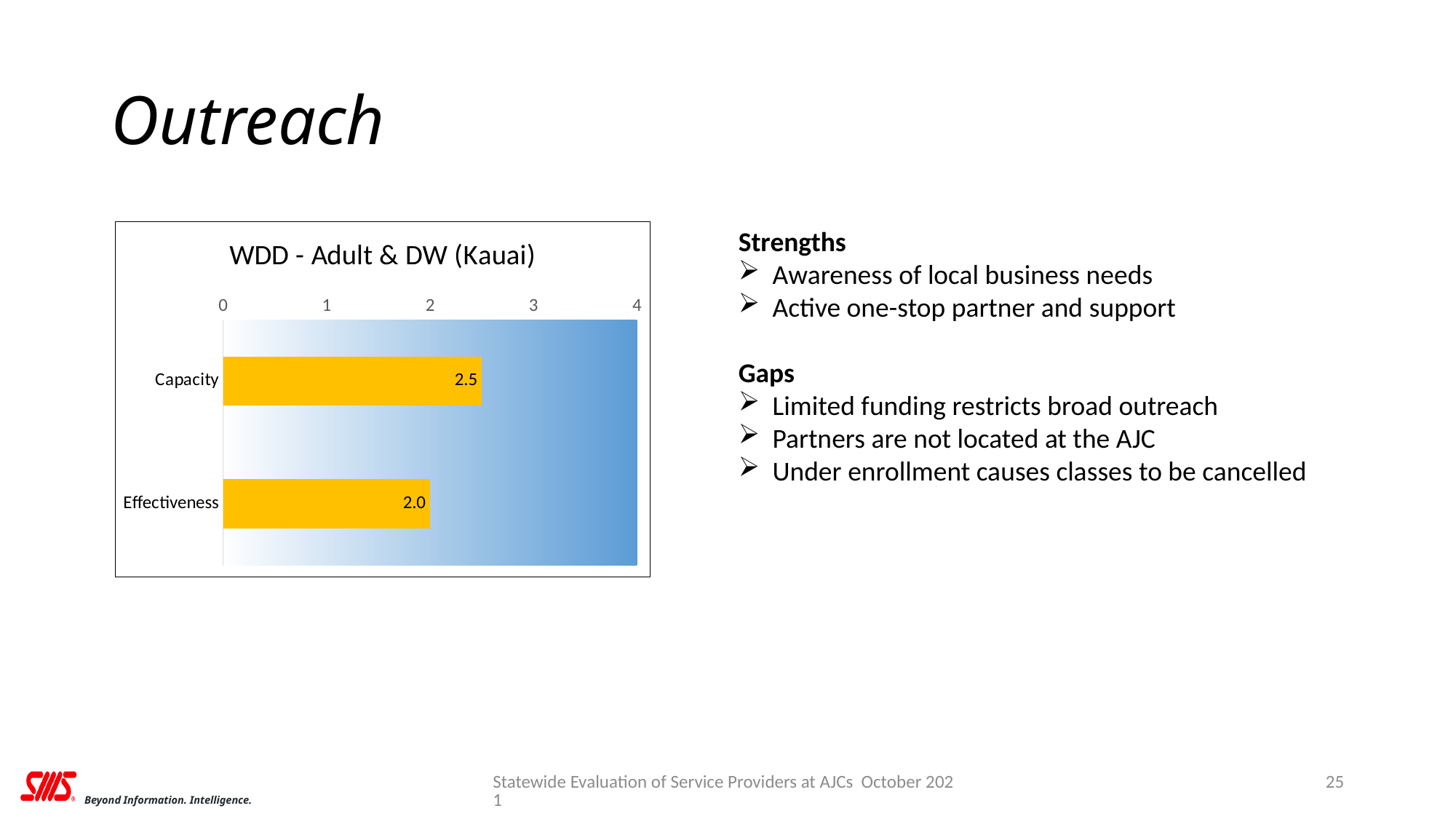
Which category has the highest value? Capacity What is the maximum value shown on the chart's axis? 4 Is the value for Effectiveness greater or less than 1? greater Is the value for Capacity greater or less than 3? less What is the difference between the Capacity and Effectiveness values? 0.5 What is the value for Effectiveness? 2.0 What kind of chart is shown on the slide? bar chart Which category has the lowest value? Effectiveness What is the value for Capacity? 2.5 How many categories are shown in the chart? 2 Which is larger, the value for Capacity or the value for Effectiveness? Capacity What is the title of the chart? WDD - Adult & DW (Kauai)